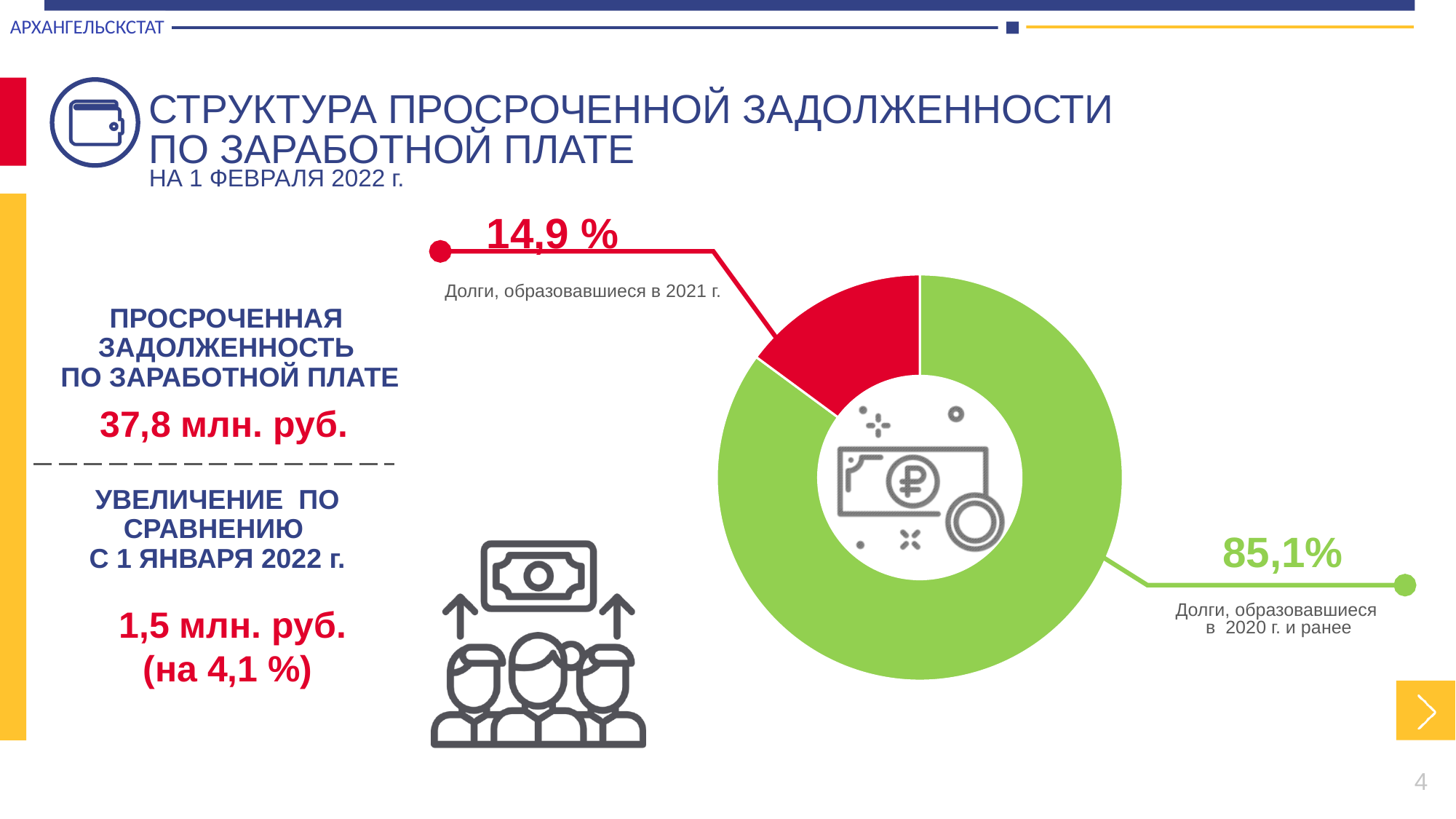
What share of the overdue wage debt is made up of debts formed in 2021 (Долги, образовавшиеся в 2021 г.)? 14,9 % What colour is the slice representing debts formed in 2021? Red What colour is the slice representing debts formed in 2020 and earlier? Green Which category has the largest share in the donut chart? Долги, образовавшиеся в 2020 г. и ранее How many slices does the donut chart have? 2 Is the share of debts formed in 2021 greater or less than 50%? less What kind of chart is shown on the slide? Donut (pie) chart Which is larger: the share of debts formed in 2021 or the share of debts formed in 2020 and earlier? Долги, образовавшиеся в 2020 г. и ранее What is the total overdue wage debt stated on the slide as of 1 February 2022? 37,8 млн. руб. Which category has the smallest share in the donut chart? Долги, образовавшиеся в 2021 г. By how many percentage points does the share of debts formed in 2020 and earlier exceed the share of debts formed in 2021? 70,2 What share of the overdue wage debt is made up of debts formed in 2020 and earlier (Долги, образовавшиеся в 2020 г. и ранее)? 85,1%